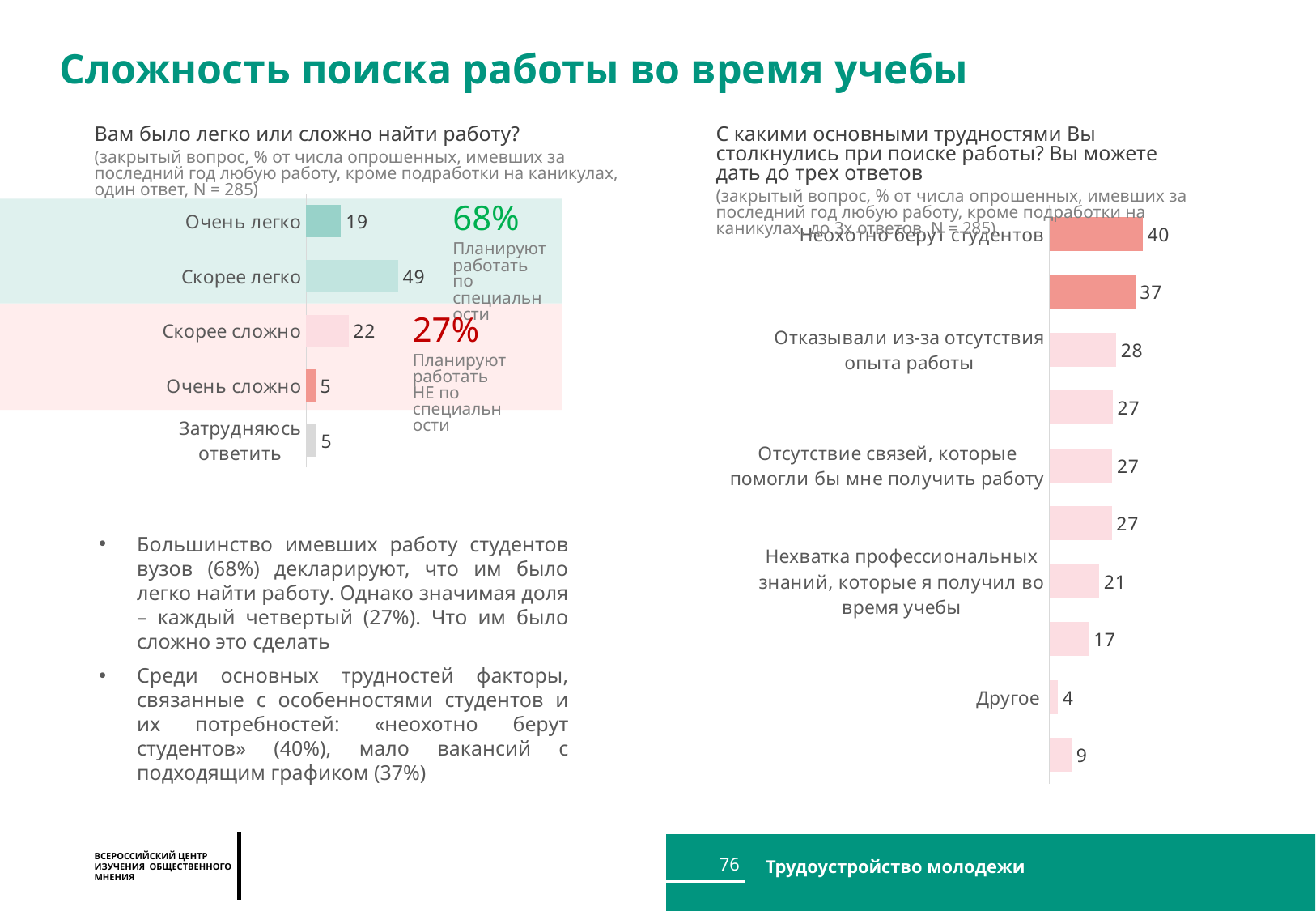
What kind of chart is the left chart 'Вам было легко или сложно найти работу?'? bar chart In the left chart 'Вам было легко или сложно найти работу?', which is larger: 'Скорее сложно' or 'Очень легко'? Скорее сложно In the left chart 'Вам было легко или сложно найти работу?', which category has the highest value? Скорее легко In the right chart about difficulties in finding work, what is the difference between 'Неохотно берут студентов' and 'Отказывали из-за отсутствия опыта работы'? 12 In the right chart about difficulties in finding work, which is larger: 'Отсутствие связей, которые помогли бы мне получить работу' or 'Нехватка профессиональных знаний, которые я получил во время учебы'? Отсутствие связей, которые помогли бы мне получить работу How many categories are shown in the left chart 'Вам было легко или сложно найти работу?'? 5 In the right chart about difficulties in finding work, what is the value for 'Отказывали из-за отсутствия опыта работы'? 28 In the left chart 'Вам было легко или сложно найти работу?', what is the value for 'Очень сложно'? 5 In the left chart 'Вам было легко или сложно найти работу?', what is the difference between 'Скорее легко' and 'Очень легко'? 30 In the right chart about difficulties in finding work, which category has the highest value? Неохотно берут студентов In the right chart about difficulties in finding work, what is the value for 'Неохотно берут студентов'? 40 In the left chart 'Вам было легко или сложно найти работу?', what is the value for 'Скорее легко'? 49